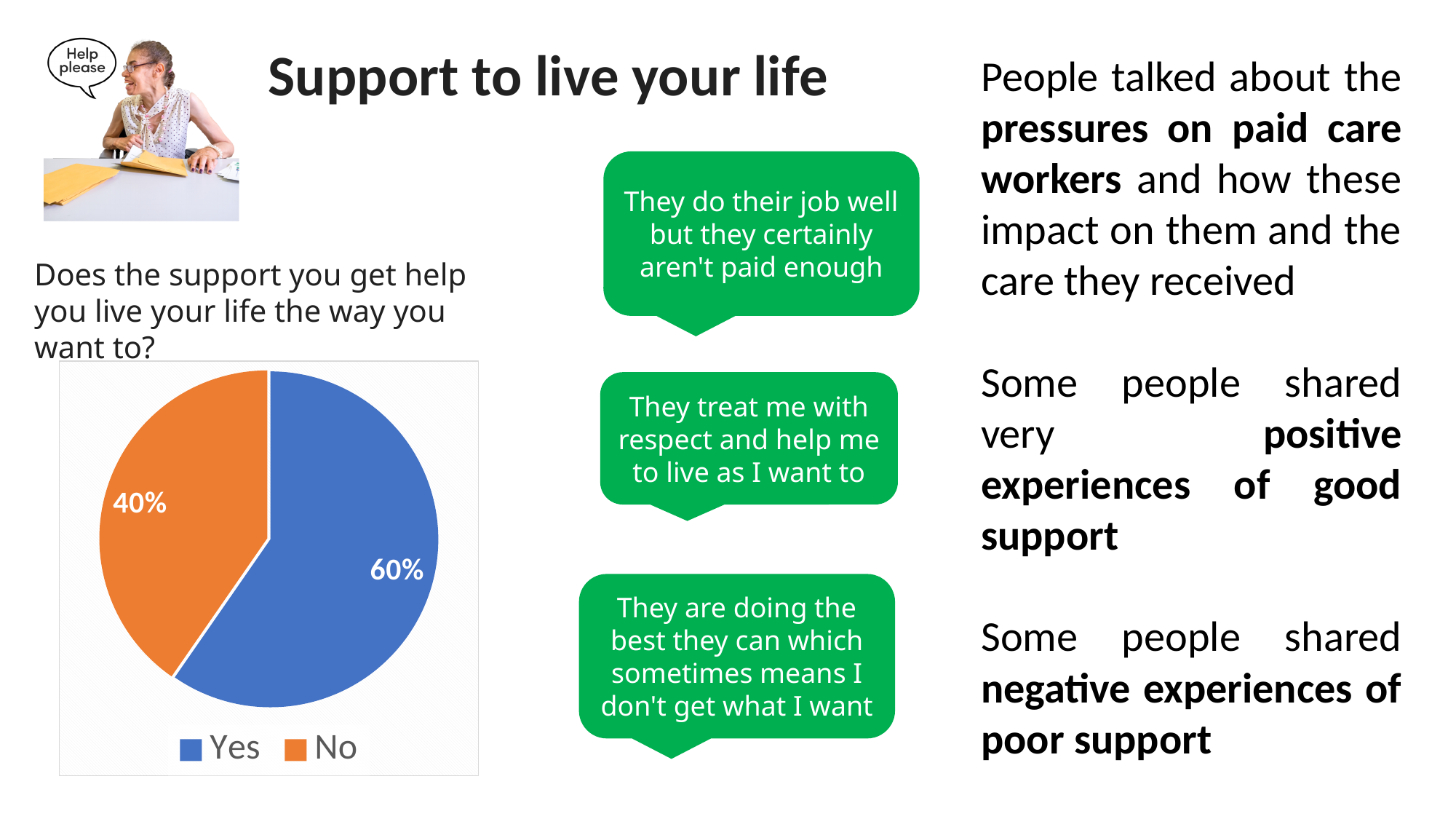
What is the difference in percentage points between the Yes and No slices? 20% What percentage of respondents answered No? 40% Which response has the larger share of the pie? Yes What kind of chart is shown on the slide? pie chart Is the share for Yes larger or smaller than the share for No? larger What percentage of respondents answered Yes? 60% How many slices does the pie chart have? 2 What share of the pie does the No slice represent? 40% What colour is the Yes slice? blue Which response has the smaller share of the pie? No How many entries does the legend list? 2 What colour is the No slice? orange